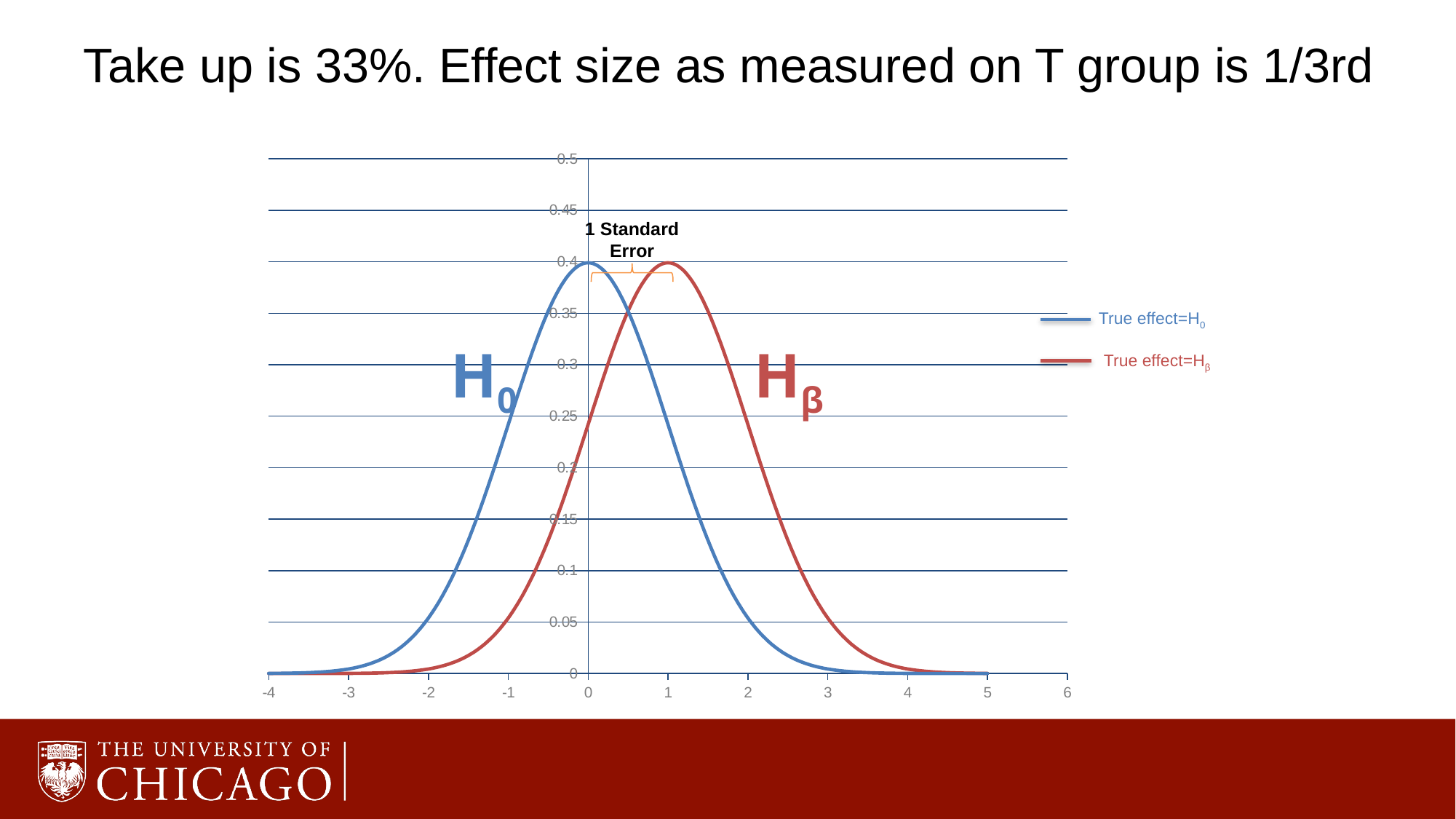
What kind of chart is shown on the slide? line chart At which x-axis value does the red Hβ curve reach its peak? 1 How many series does the chart's legend list? 2 At x = -1, which curve has the higher value, the blue H0 curve or the red Hβ curve? blue H0 curve At which x-axis value does the blue H0 curve reach its peak? 0 Is the peak value of the blue H0 curve greater or less than 0.35? greater At x = 2, which curve has the higher value, the blue H0 curve or the red Hβ curve? red Hβ curve What are the two legend entries of the chart? True effect=H0 and True effect=Hβ What is the range of the x axis, from its lowest to its highest tick? -4 to 6 Does the blue H0 curve rise or fall as x increases from 0 to 4? fall Is the value of the red Hβ curve at x = 0 greater or less than 0.3? less What colour is the curve labelled H0? blue